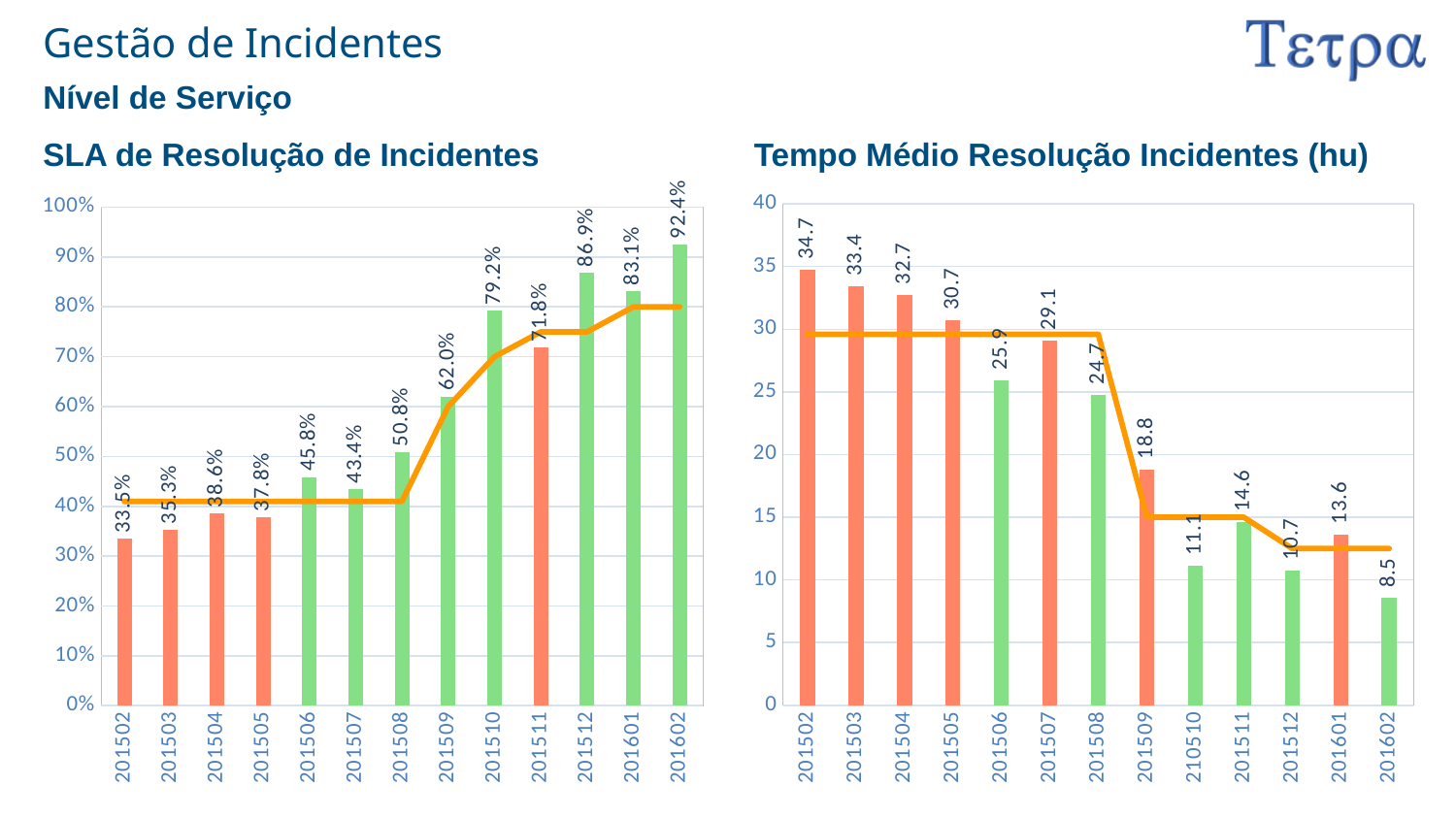
In the 'Tempo Médio Resolução Incidentes (hu)' chart, what is the value for 201509? 18.8 In the 'SLA de Resolução de Incidentes' chart, which period has the lowest value? 201502 In the 'SLA de Resolução de Incidentes' chart, what is the value for 201602? 92.4% In the 'Tempo Médio Resolução Incidentes (hu)' chart, what is the value for 201502? 34.7 In the 'Tempo Médio Resolução Incidentes (hu)' chart, what is the difference between the values for 201502 and 201602? 26.2 In the 'SLA de Resolução de Incidentes' chart, what is the difference between the values for 201512 and 201511? 15.1% In the 'Tempo Médio Resolução Incidentes (hu)' chart, which is larger, the value for 201507 or the value for 201508? 201507 In the 'SLA de Resolução de Incidentes' chart, what is the value for 201508? 50.8% In the 'Tempo Médio Resolução Incidentes (hu)' chart, which period has the lowest value? 201602 In the 'SLA de Resolução de Incidentes' chart, do the values generally rise or fall from 201502 to 201602? rise In the 'SLA de Resolução de Incidentes' chart, how many bars are plotted? 13 What kind of chart is the 'Tempo Médio Resolução Incidentes (hu)' chart? combination bar and line chart